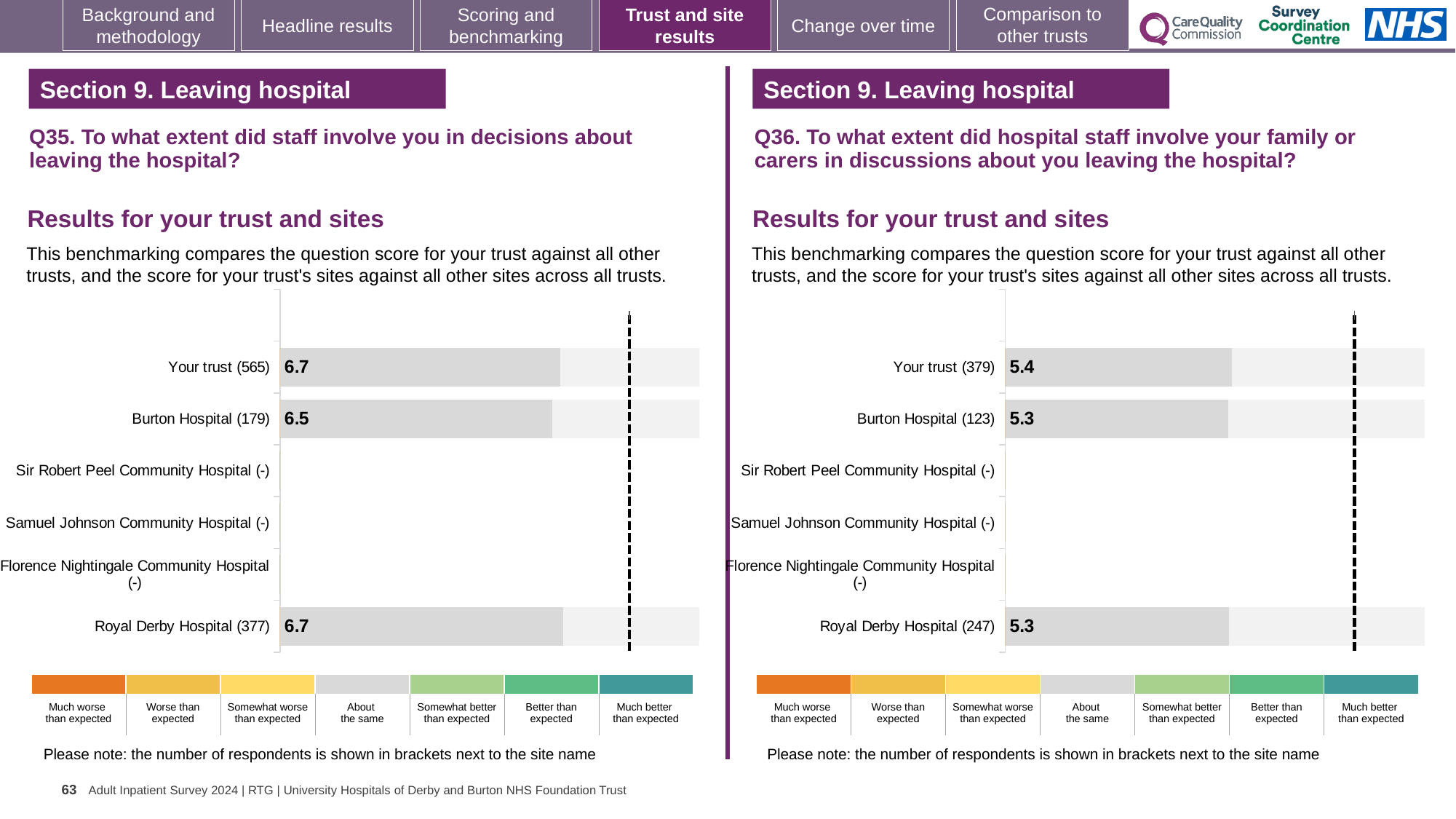
On the Q35 chart (left), what is the score for Burton Hospital? 6.5 On the Q35 chart (left), what is the difference between the score for Your trust and the score for Burton Hospital? 0.2 What kind of chart is used on the Q36 chart (right)? Bar chart On the Q36 chart (right), what is the difference between the score for Your trust and the score for Burton Hospital? 0.1 On the Q35 chart (left), what is the score for Royal Derby Hospital? 6.7 On the Q36 chart (right), what is the score for Your trust? 5.4 On the Q35 chart (left), which site with a score shown has the lowest score? Burton Hospital On the Q36 chart (right), which row has the highest score? Your trust On the Q36 chart (right), which is larger: the score for Your trust or the score for Royal Derby Hospital? Your trust How many rows (trust and sites) are listed on the Q35 chart (left)? 6 On the Q36 chart (right), what is the score for Royal Derby Hospital? 5.3 On the Q35 chart (left), what is the score for Your trust? 6.7